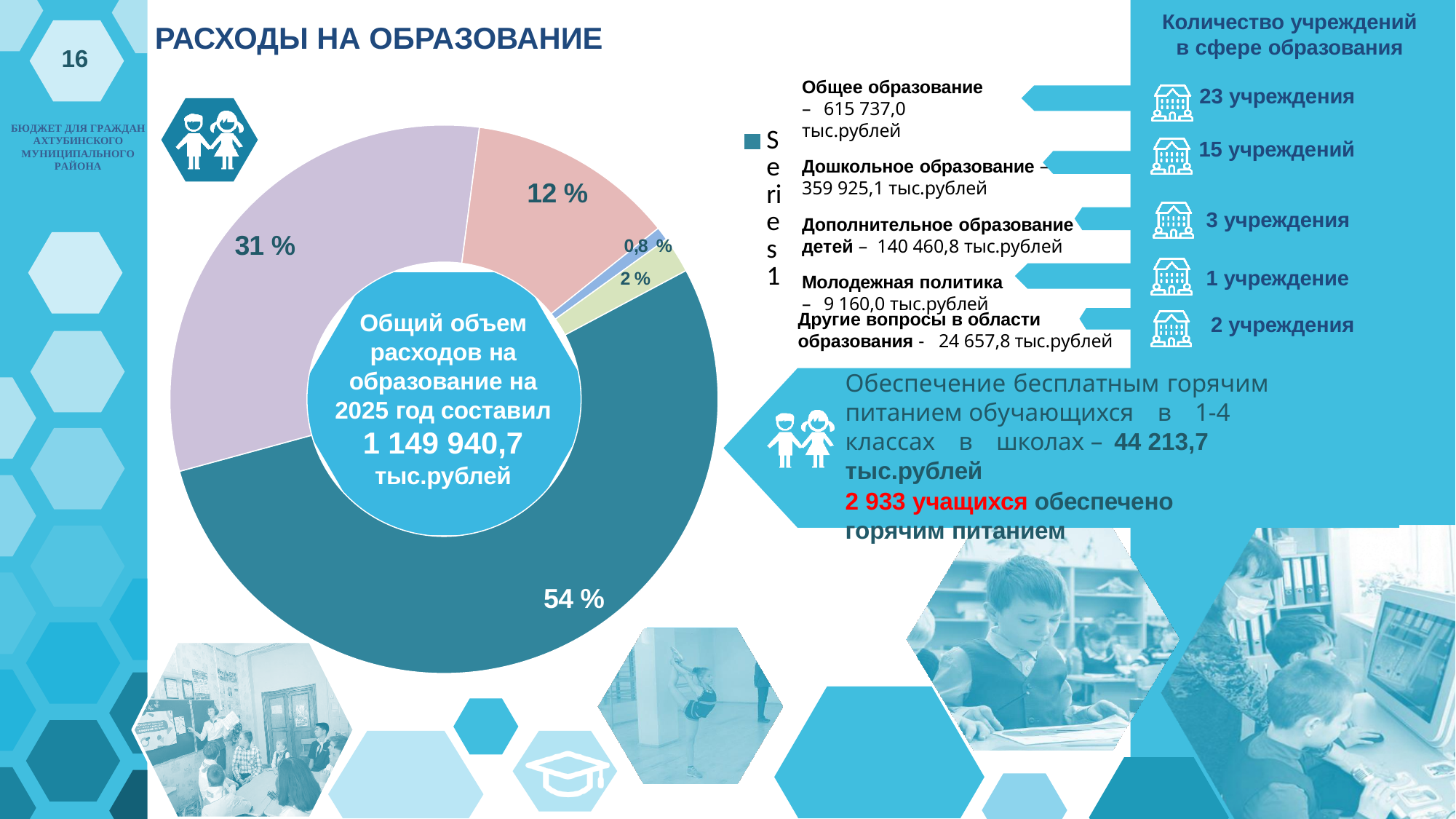
What is the percentage shown on the light green slice of the pie chart? 2 % What is the percentage shown on the largest slice of the pie chart? 54 % What legend entry is shown next to the pie chart? Series1 Which slice is larger in the pie chart: the one labelled 12 % or the one labelled 2 %? 12 % What kind of chart is shown on the slide? Pie chart (donut) What is the title of the slide containing the pie chart? РАСХОДЫ НА ОБРАЗОВАНИЕ How many slices does the pie chart have? 5 What is the percentage shown on the smallest slice of the pie chart? 0,8 % What is the percentage shown on the pink slice of the pie chart? 12 % What is the difference between the largest slice (54 %) and the second-largest slice (31 %) of the pie chart? 23 % What total amount is printed in the centre of the donut chart? 1 149 940,7 тыс.рублей What is the percentage shown on the light purple slice of the pie chart? 31 %